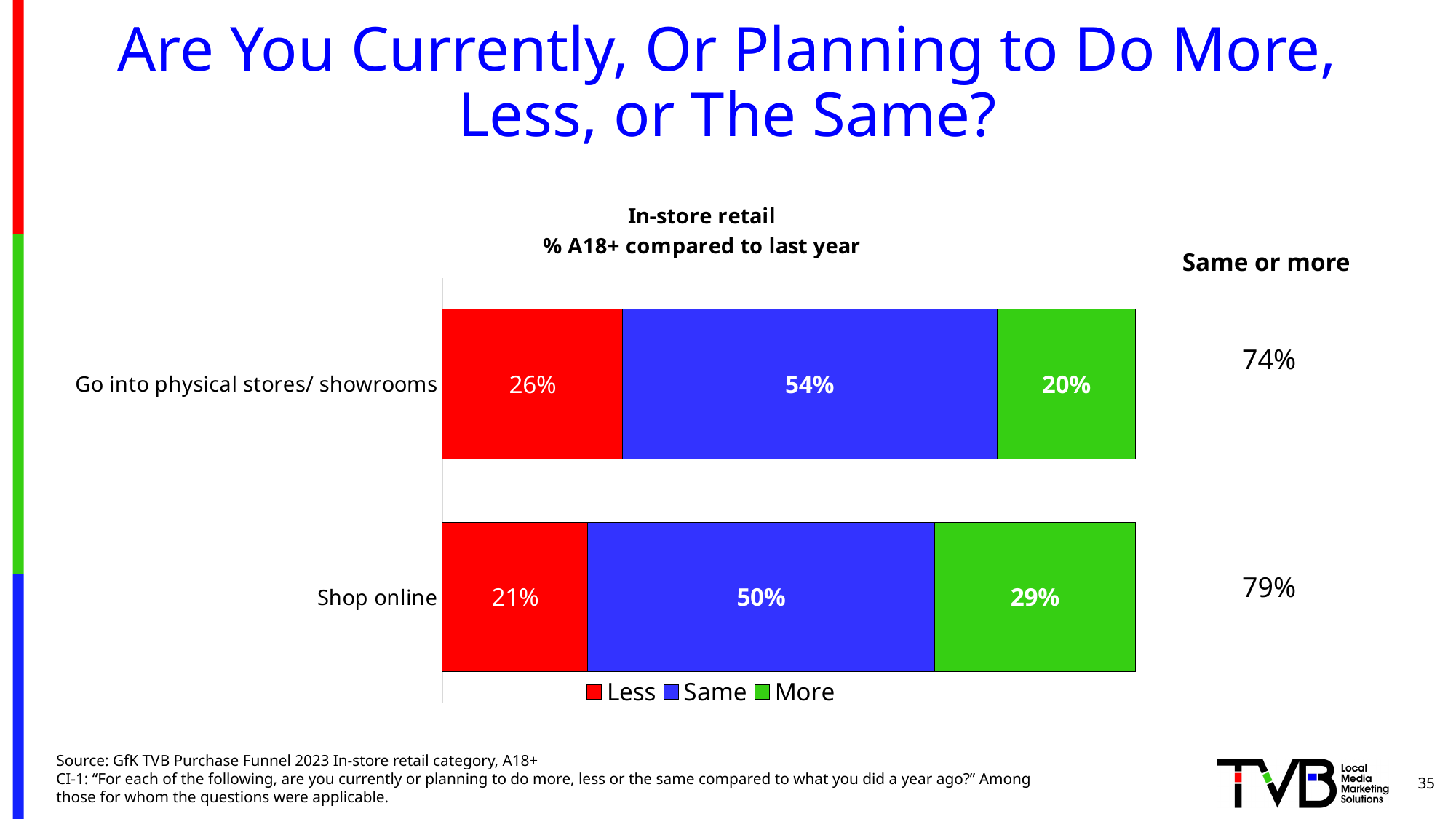
What percentage of A18+ say they will shop online the same as last year? 50% What is the 'Same or more' figure for going into physical stores/showrooms? 74% Which category has the larger 'More' share, going into physical stores/showrooms or shopping online? Shop online What percentage of A18+ say they will shop online more? 29% What kind of chart is shown on the slide? Stacked bar chart How many series does the legend list? 3 What is the difference between the 'Less' percentages for going into physical stores/showrooms and shopping online? 5% What is the difference between the 'Same' percentages for going into physical stores/showrooms and shopping online? 4% Which colour represents the 'Same' series in the chart? Blue What percentage of A18+ say they will do less going into physical stores/showrooms? 26% What is the total of the stacked bar for Shop online? 100% How many categories are shown in the chart? 2